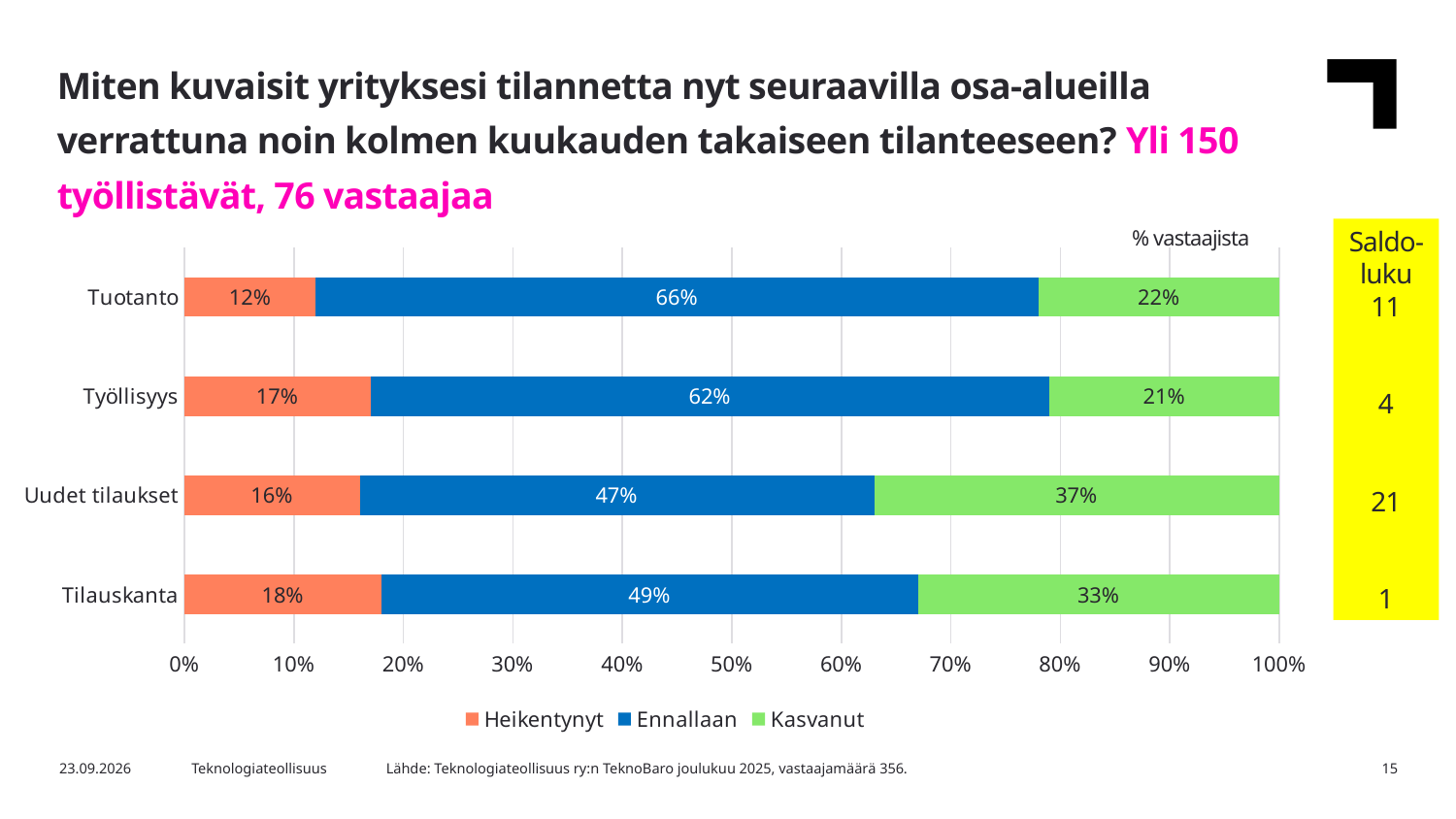
What is the total of the stacked bar for Työllisyys? 100% How many series does the legend list? 3 What is the difference between the 'Ennallaan' values for Tuotanto and Tilauskanta? 17 percentage points Which is larger: the 'Kasvanut' value for Työllisyys or for Tilauskanta? Tilauskanta What percentage of respondents reported 'Ennallaan' for Tuotanto? 66% What kind of chart is shown on the slide? Stacked bar chart Which category has the lowest 'Heikentynyt' share? Tuotanto Which category has the highest 'Kasvanut' share? Uudet tilaukset How many categories are shown on the chart? 4 What is the 'Heikentynyt' value for Tilauskanta? 18% What is the 'Saldoluku' value shown for Uudet tilaukset? 21 What is the 'Kasvanut' value for Uudet tilaukset? 37%